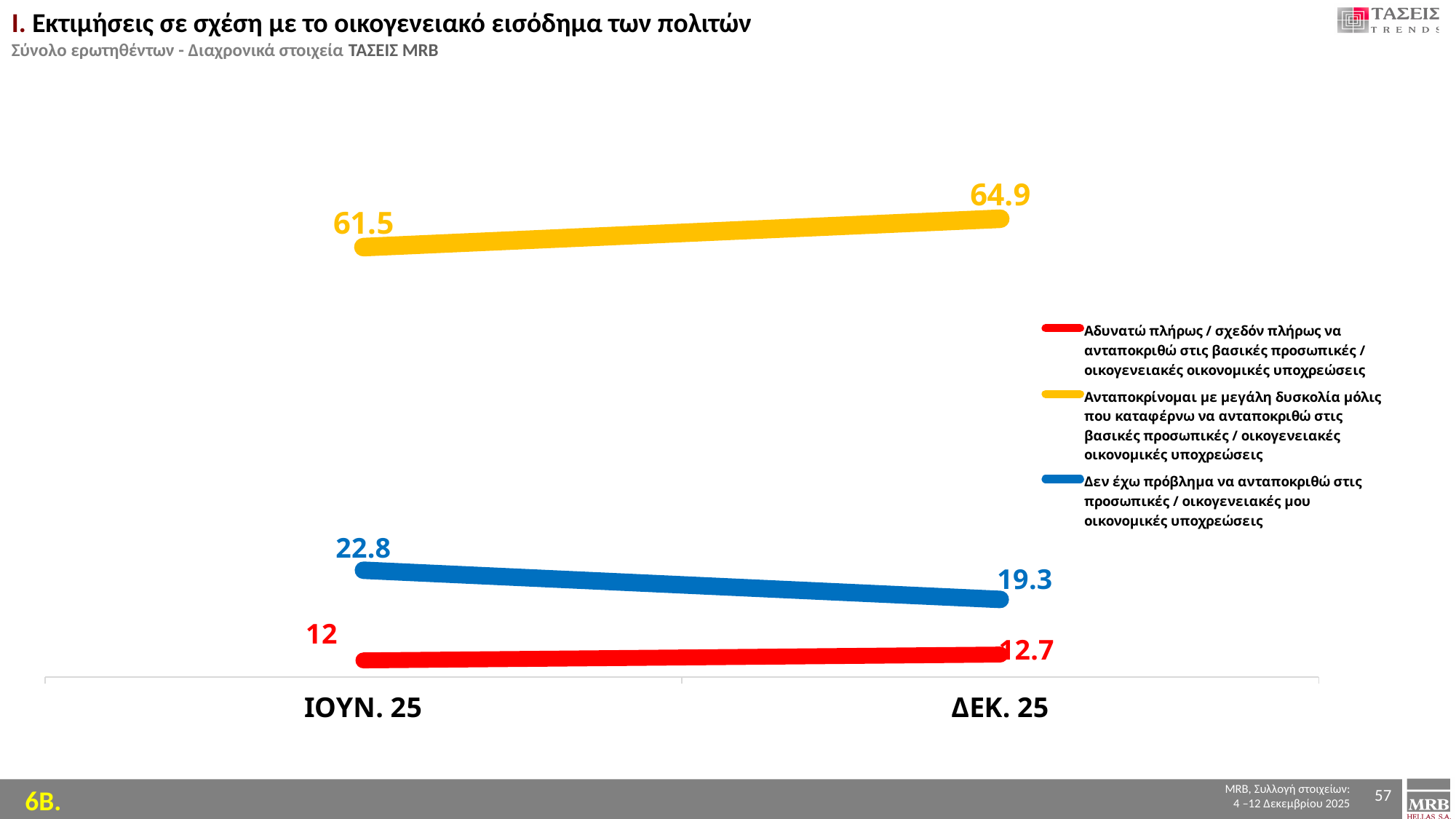
What type of chart is shown on the slide? Line chart Which series has the lowest value at ΙΟΥΝ. 25? Αδυνατώ πλήρως / σχεδόν πλήρως να ανταποκριθώ στις βασικές προσωπικές / οικογενειακές οικονομικές υποχρεώσεις What is the value of the yellow series (Ανταποκρίνομαι με μεγάλη δυσκολία...) for ΙΟΥΝ. 25? 61.5 What is the value of the blue series (Δεν έχω πρόβλημα να ανταποκριθώ...) for ΔΕΚ. 25? 19.3 What is the value of the red series (Αδυνατώ πλήρως / σχεδόν πλήρως...) for ΙΟΥΝ. 25? 12 Which series has the highest value at ΔΕΚ. 25? Ανταποκρίνομαι με μεγάλη δυσκολία μόλις που καταφέρνω να ανταποκριθώ στις βασικές προσωπικές / οικογενειακές οικονομικές υποχρεώσεις By how much did the blue series (Δεν έχω πρόβλημα να ανταποκριθώ...) change from ΙΟΥΝ. 25 to ΔΕΚ. 25? Decreased by 3.5 How many series does the legend list? 3 How many time points are shown on the x axis? 2 Which is larger: the red series value at ΔΕΚ. 25 or the blue series value at ΔΕΚ. 25? The blue series (19.3) What is the value of the yellow series (Ανταποκρίνομαι με μεγάλη δυσκολία...) for ΔΕΚ. 25? 64.9 Does the yellow series (Ανταποκρίνομαι με μεγάλη δυσκολία...) rise or fall from ΙΟΥΝ. 25 to ΔΕΚ. 25? Rise